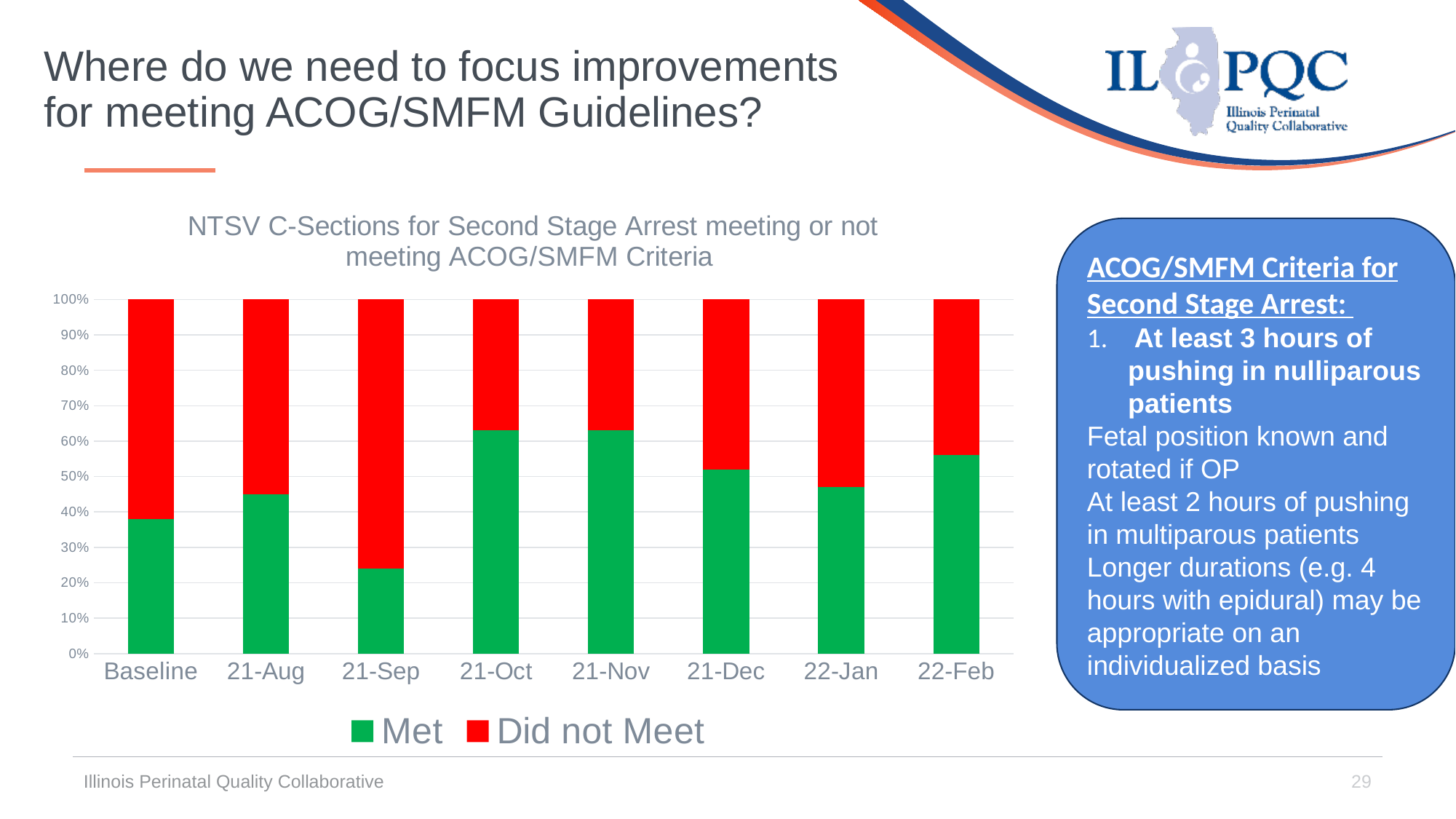
Is the Met value for 21-Sep greater or less than 30%? less Is the Met value for 21-Aug greater or less than 50%? less How many categories are shown along the x axis of the chart? 8 How many series does the chart's legend list? 2 Which has the larger Met share, 21-Oct or 21-Sep? 21-Oct What are the two series named in the legend? Met and Did not Meet Which has the larger Met share, 22-Feb or Baseline? 22-Feb What kind of chart is shown on the slide? Stacked bar chart What is the title of the chart? NTSV C-Sections for Second Stage Arrest meeting or not meeting ACOG/SMFM Criteria Which category has the lowest Met share? 21-Sep Is the Met value for 21-Oct greater or less than 60%? greater Which category has the highest Did not Meet share? 21-Sep